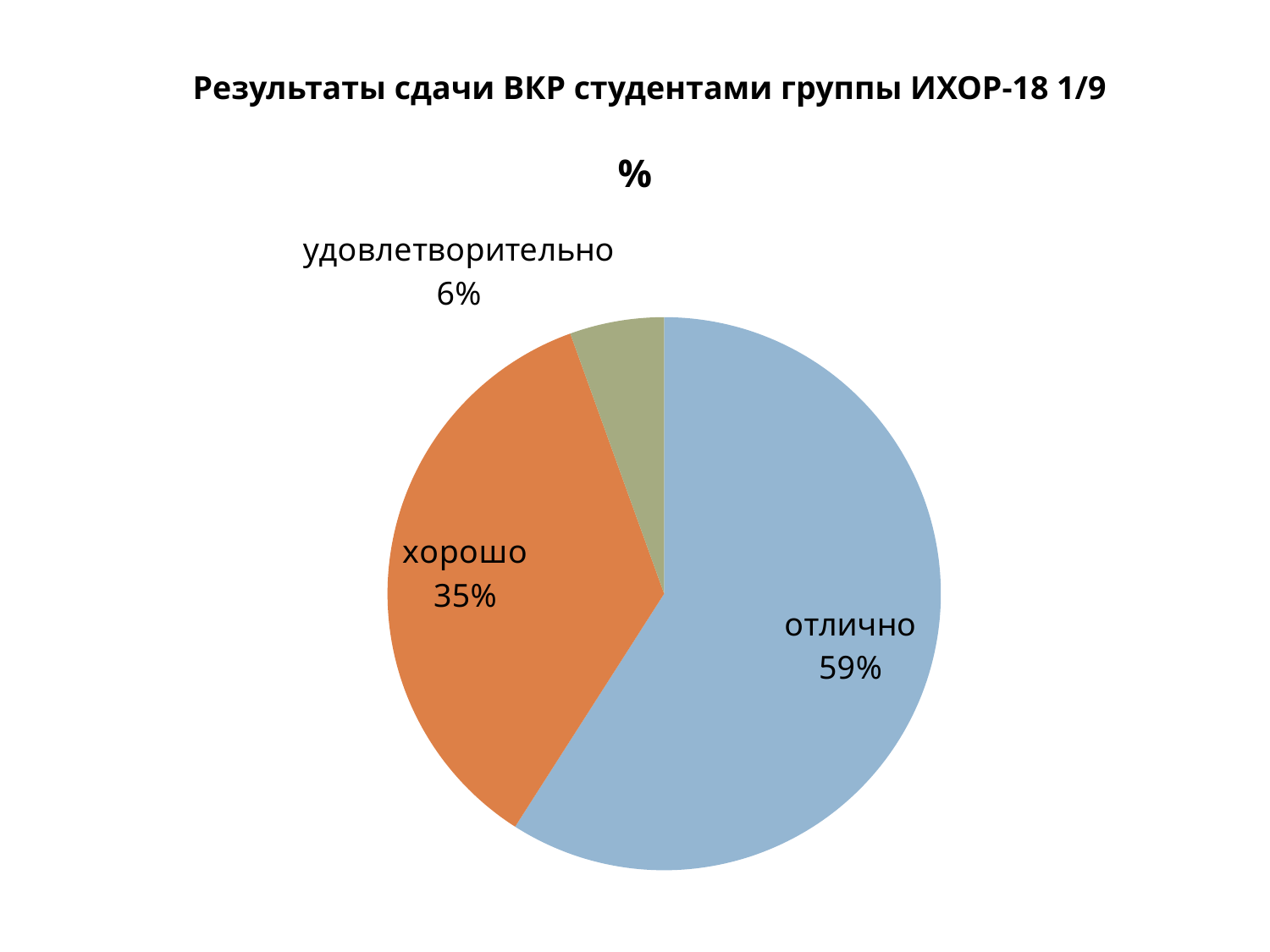
What is the difference in percentage points between the "отлично" and "хорошо" slices? 24 What kind of chart is shown on the slide? pie chart What is the difference in percentage points between the "хорошо" and "удовлетворительно" slices? 29 Which slice is larger, "хорошо" or "удовлетворительно"? хорошо What colour is the "отлично" slice? blue How many slices does the pie chart have? 3 What share of the pie does the "отлично" slice represent? 59% What is the title of the chart? % Which category has the largest slice of the pie? отлично What share of the pie does the "хорошо" slice represent? 35% Which category has the smallest slice of the pie? удовлетворительно What share of the pie does the "удовлетворительно" slice represent? 6%